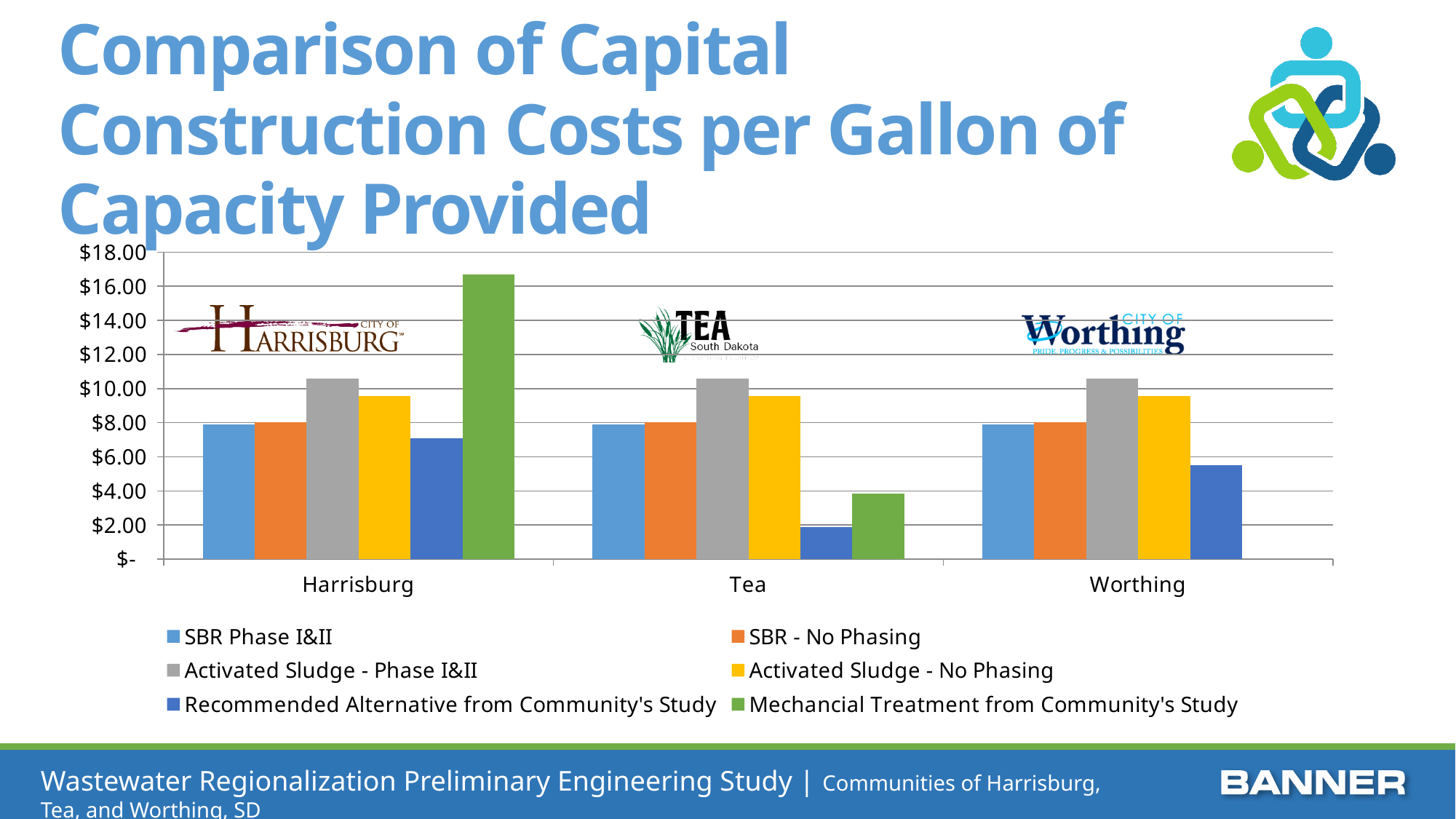
How many communities (categories) are shown on the x axis of the chart? 3 Is the value for Recommended Alternative from Community's Study for Worthing greater or less than $6.00? less Which is larger: the Recommended Alternative from Community's Study value for Harrisburg or for Worthing? Harrisburg For Harrisburg, which series has the highest cost per gallon? Mechancial Treatment from Community's Study Is the value for Mechancial Treatment from Community's Study for Harrisburg greater or less than $16.00? greater What kind of chart is shown on the slide? bar chart For Tea, which series has the lowest cost per gallon? Recommended Alternative from Community's Study Is the value for Mechancial Treatment from Community's Study for Tea greater or less than $2.00? greater Which community has no bar for Mechancial Treatment from Community's Study? Worthing For Worthing, which is larger: Activated Sludge - Phase I&II or Activated Sludge - No Phasing? Activated Sludge - Phase I&II How many series does the chart's legend list? 6